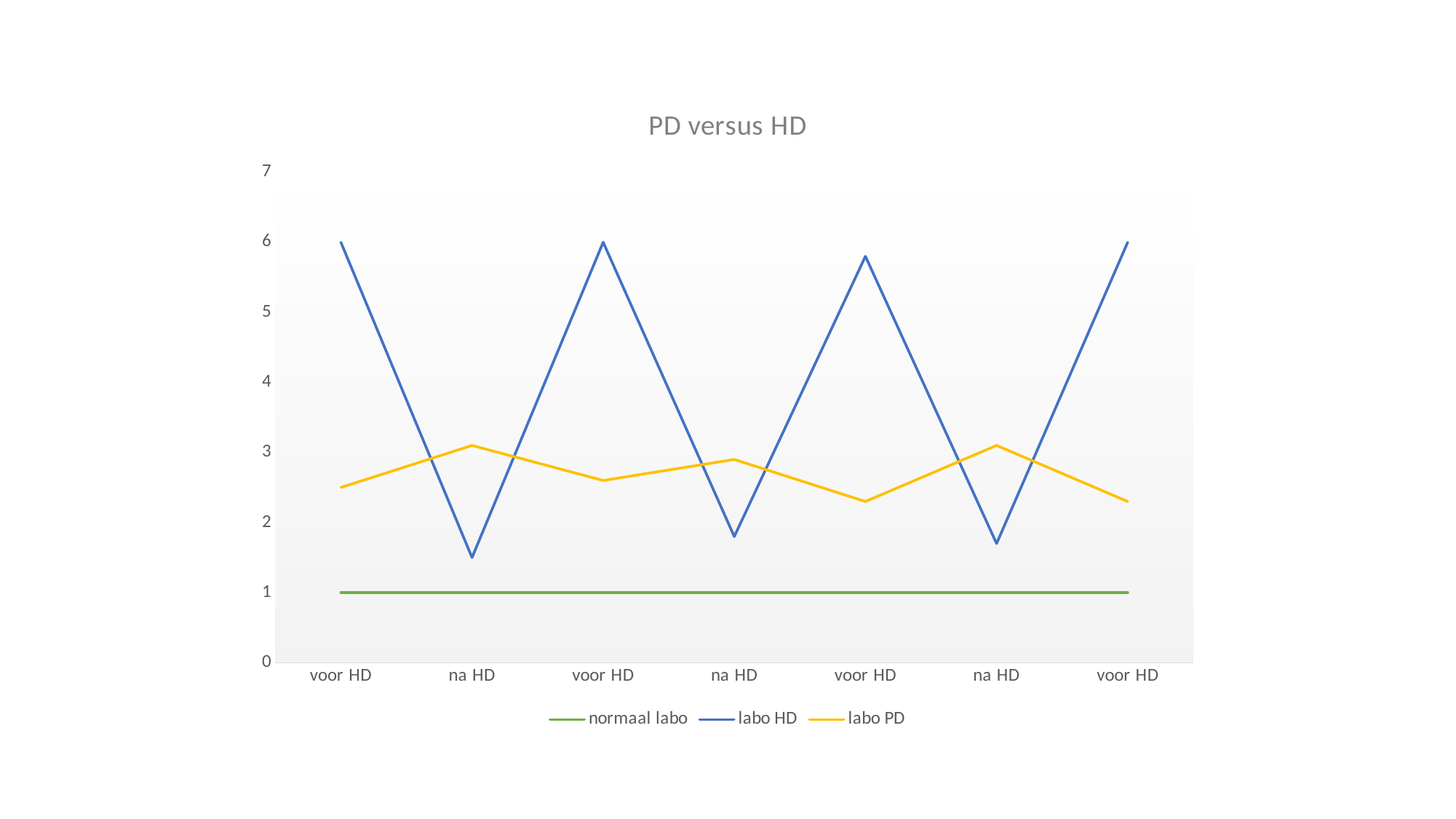
At the first na HD, which series has the larger value, labo HD or labo PD? labo PD Which series has the lowest value at every point on the chart? normaal labo At the first voor HD, which series has the larger value, labo HD or labo PD? labo HD How many points are plotted along the x axis for each series? 7 What is the title of the chart? PD versus HD Does the labo HD series rise or fall from the first voor HD to the first na HD? fall Is the value of labo HD at the first na HD greater or less than 2? less How many series does the legend list? 3 What kind of chart is shown on the slide? line chart What is the value of the normaal labo series across the chart? 1 Is the value of labo PD at the first voor HD greater or less than 3? less Is the value of labo HD at the first voor HD greater or less than 5? greater